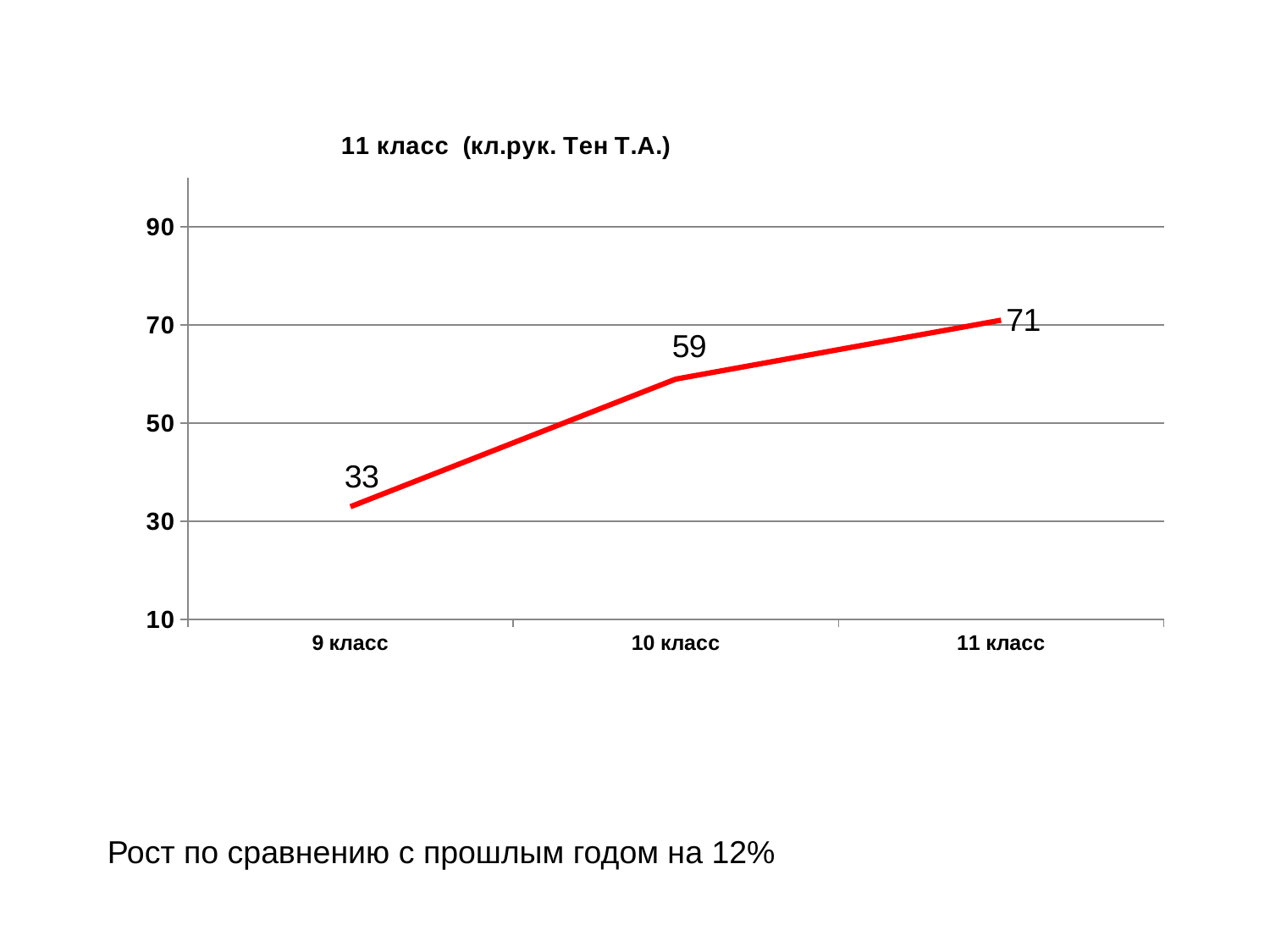
What is the difference between the values for 10 класс and 9 класс? 26 Do the values rise or fall from 9 класс to 11 класс? rise Which category has the highest value? 11 класс What kind of chart is shown on the slide? line chart How many categories are shown on the x axis? 3 Which is larger, the value for 9 класс or the value for 10 класс? 10 класс Which category has the lowest value? 9 класс What is the value for 11 класс? 71 What is the value for 10 класс? 59 Is the value for 11 класс greater or less than 70? greater What is the difference between the values for 11 класс and 10 класс? 12 What is the value for 9 класс? 33